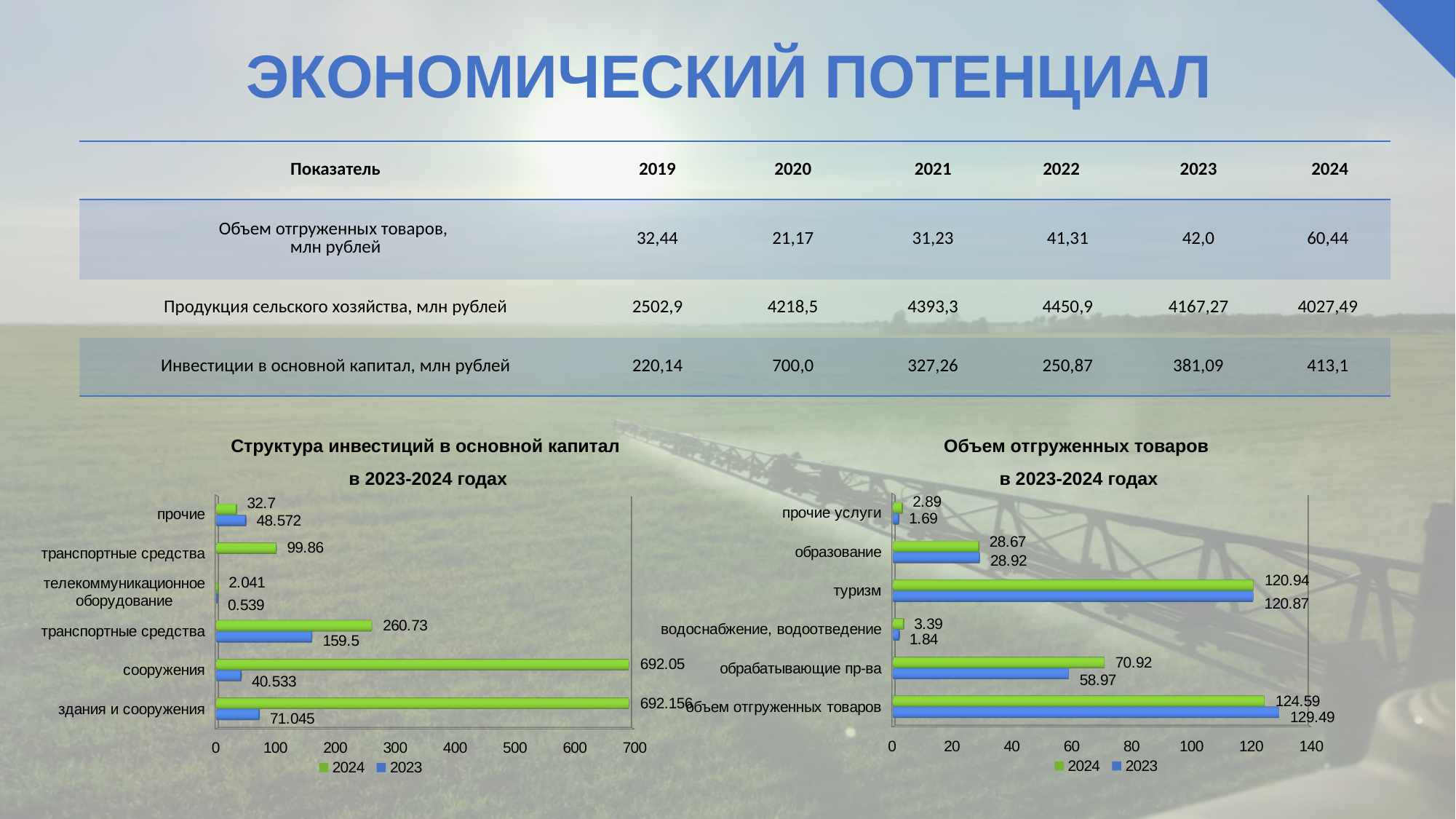
On the chart "Объем отгруженных товаров в 2023-2024 годах", which category has the highest 2024 value? объем отгруженных товаров On the chart "Объем отгруженных товаров в 2023-2024 годах", which category has the lowest 2023 value? прочие услуги On the chart "Объем отгруженных товаров в 2023-2024 годах", what is the difference between the 2024 and 2023 values for обрабатывающие пр-ва? 11.95 On the chart "Структура инвестиций в основной капитал в 2023-2024 годах", which category has the lowest 2024 value? телекоммуникационное оборудование On the chart "Структура инвестиций в основной капитал в 2023-2024 годах", what is the 2024 value for прочие? 32.7 On the chart "Объем отгруженных товаров в 2023-2024 годах", what is the 2023 value for обрабатывающие пр-ва? 58.97 On the chart "Объем отгруженных товаров в 2023-2024 годах", what is the 2024 value for туризм? 120.94 On the chart "Структура инвестиций в основной капитал в 2023-2024 годах", is the 2024 value for здания и сооружения larger than the 2023 value? Yes On the chart "Структура инвестиций в основной капитал в 2023-2024 годах", what is the 2023 value for сооружения? 40.533 On the chart "Объем отгруженных товаров в 2023-2024 годах", how many series does the legend list? 2 What type of chart is "Структура инвестиций в основной капитал в 2023-2024 годах"? bar chart On the chart "Объем отгруженных товаров в 2023-2024 годах", how many categories are shown? 6